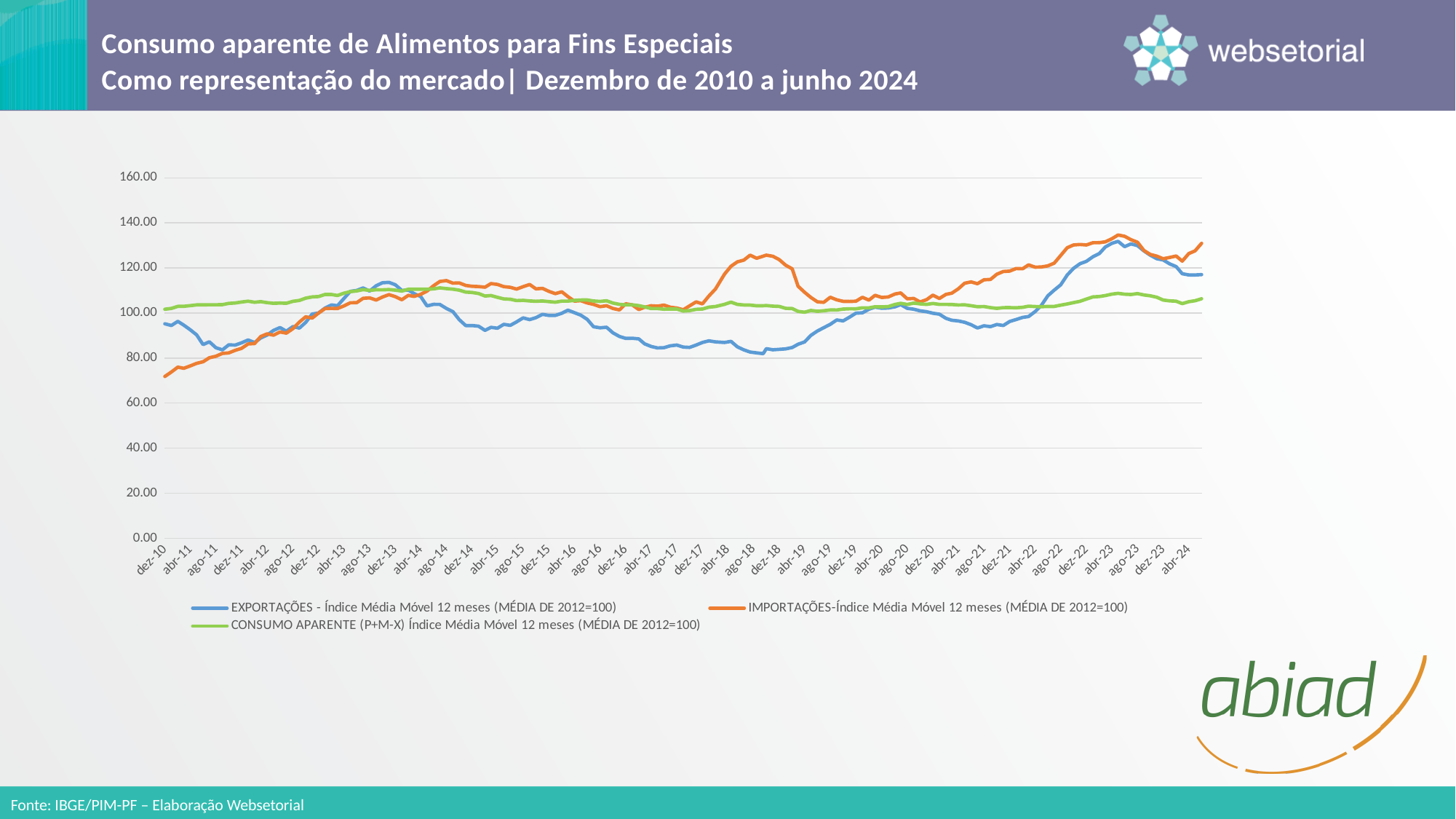
At dez-10, which series has the higher value, EXPORTAÇÕES or IMPORTAÇÕES? EXPORTAÇÕES Is the value of EXPORTAÇÕES at ago-17 greater or less than 100? less Is the value of IMPORTAÇÕES at dez-18 greater or less than 120? greater How many series does the legend list? 3 Is the value of EXPORTAÇÕES at abr-23 greater or less than 120? greater Which series has the highest value at abr-24? IMPORTAÇÕES Does the IMPORTAÇÕES line rise or fall between dez-10 and dez-12? rise What colour is the CONSUMO APARENTE (P+M-X) line? green Does the EXPORTAÇÕES line rise or fall between abr-23 and abr-24? fall What kind of chart is shown on the slide? line chart At dez-18, which series has the higher value, EXPORTAÇÕES or IMPORTAÇÕES? IMPORTAÇÕES